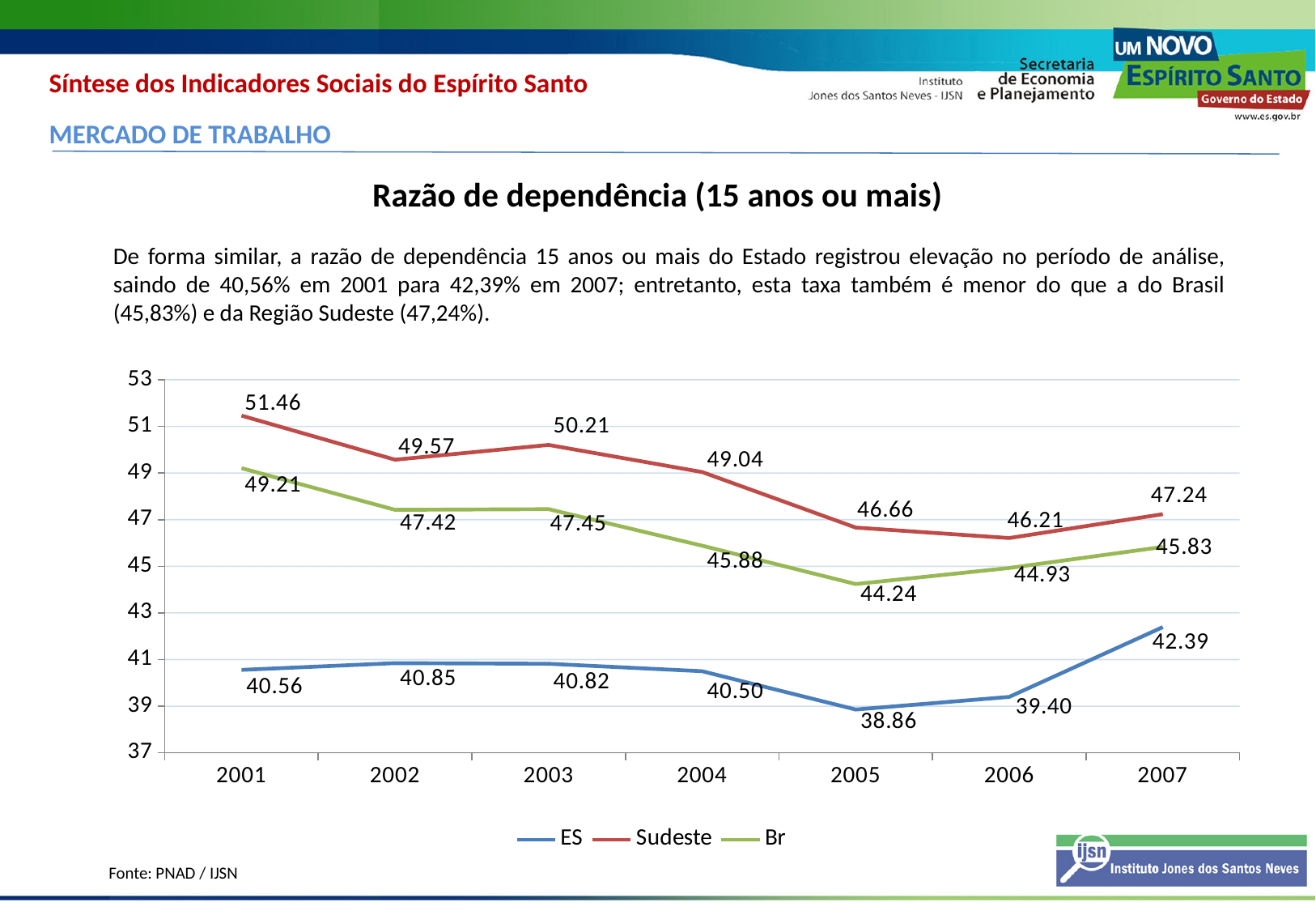
Does the Sudeste series rise or fall from 2001 to 2005? fall What is the value for Sudeste in 2003? 50.21 What is the title of the chart? Razão de dependência (15 anos ou mais) What type of chart is shown on the slide? line chart What is the value for Br in 2005? 44.24 What is the value for ES in 2007? 42.39 In which year is the ES series lowest? 2005 How many years are shown on the x axis? 7 What is the difference between the Sudeste and Br values in 2007? 1.41 Which is larger in 2001: the value for Br or the value for ES? Br How many series does the legend list? 3 In which year is the Sudeste series highest? 2001